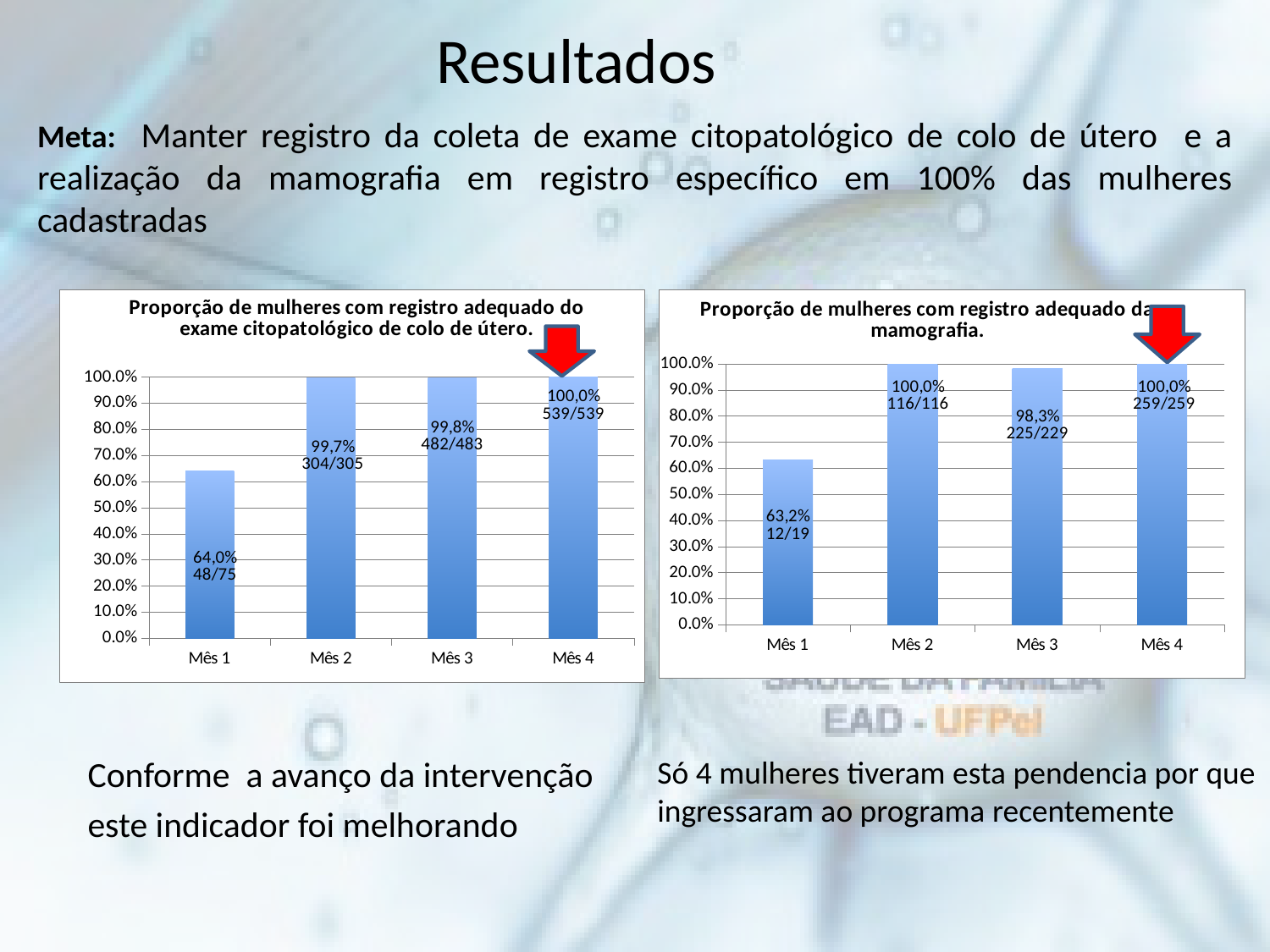
How many months (categories) are shown in the left chart (exame citopatológico de colo de útero)? 4 In the left chart (exame citopatológico de colo de útero), which month has the highest value? Mês 4 In the right chart (mamografia), is the value for Mês 1 greater or less than 70.0%? less In the left chart (exame citopatológico de colo de útero), what fraction is shown for Mês 3? 482/483 In the right chart (mamografia), what is the value for Mês 3? 98,3% In the right chart (mamografia), which month has the lowest value? Mês 1 What type of chart is the right chart (mamografia)? Bar chart In the right chart (mamografia), which is larger, the value for Mês 1 or the value for Mês 3? Mês 3 In the left chart (exame citopatológico de colo de útero), what is the difference in percentage points between Mês 4 and Mês 1? 36,0 percentage points In the right chart (mamografia), what fraction is shown for Mês 1? 12/19 In the left chart (exame citopatológico de colo de útero), what is the value for Mês 1? 64,0% In the left chart (exame citopatológico de colo de útero), do the values rise or fall from Mês 1 to Mês 4? Rise